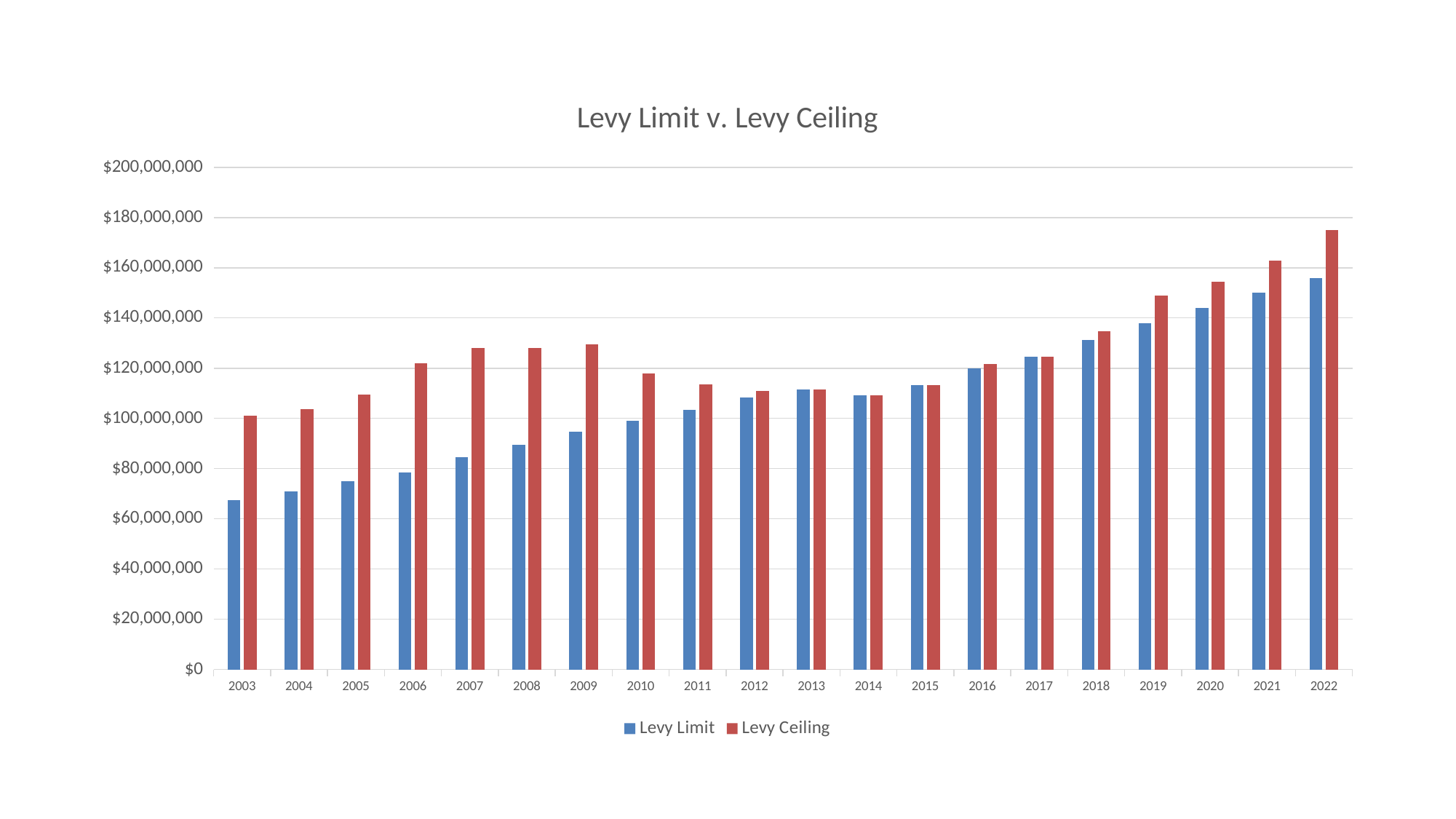
In 2009, which is larger, the Levy Limit or the Levy Ceiling? Levy Ceiling What kind of chart is shown on the slide? Bar chart Does the Levy Limit generally rise or fall from 2003 to 2022? Rise Is the Levy Ceiling for 2014 greater or less than $120,000,000? less Is the Levy Limit for 2022 greater or less than $140,000,000? greater How many years are shown on the x axis? 20 Is the Levy Limit for 2003 greater or less than $80,000,000? less How many series does the legend list? 2 In which year is the Levy Ceiling highest? 2022 What is the title of the chart? Levy Limit v. Levy Ceiling In which year is the Levy Limit lowest? 2003